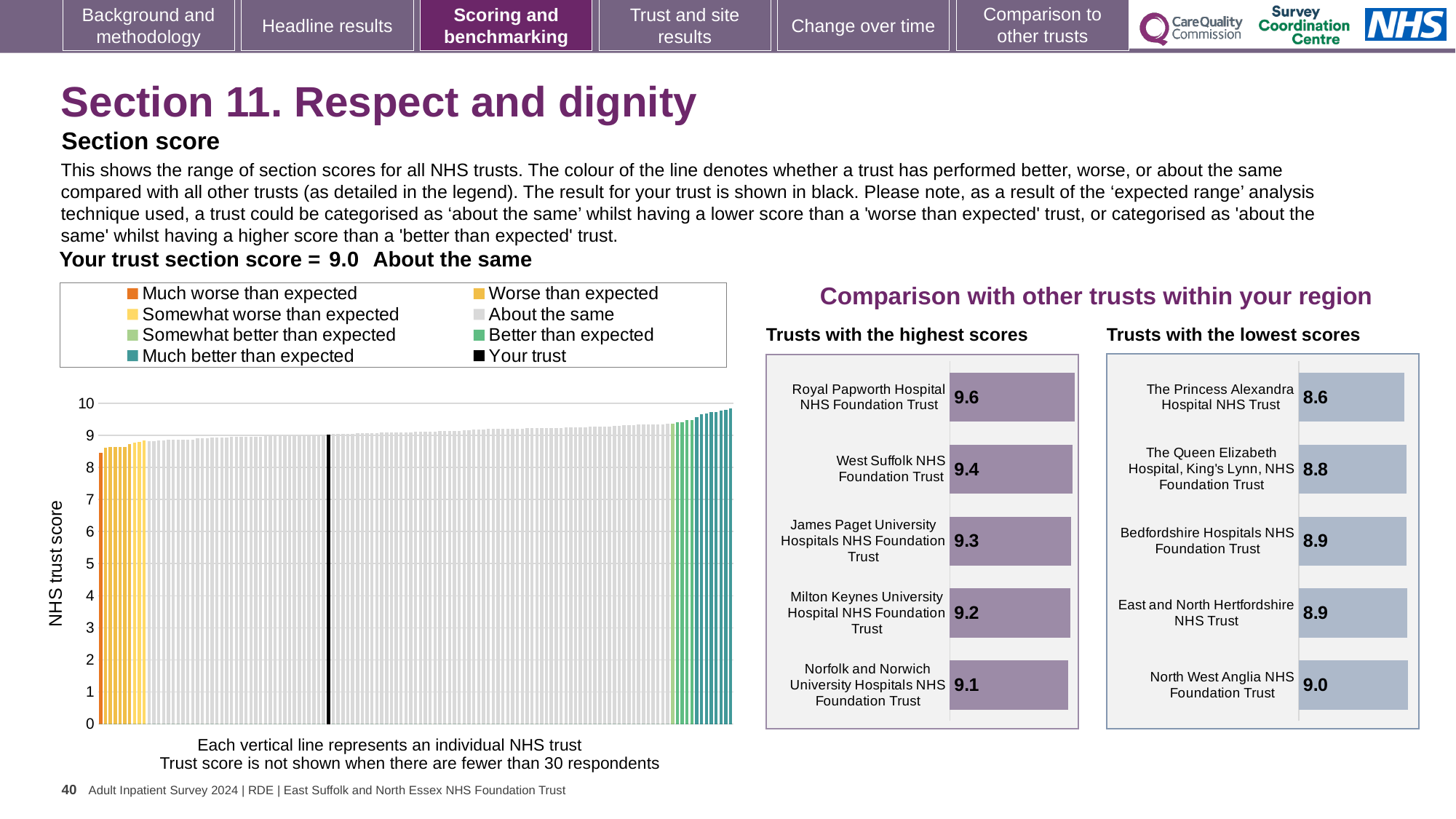
How many entries does the legend of the NHS trust score chart on the left list? 8 How many trusts are shown in the 'Trusts with the highest scores' chart? 5 In the 'Trusts with the highest scores' chart, what is the score for James Paget University Hospitals NHS Foundation Trust? 9.3 In the 'Trusts with the highest scores' chart, what is the score for Royal Papworth Hospital NHS Foundation Trust? 9.6 What is the section score for your trust shown in the NHS trust score chart on the left? 9.0 In the 'Trusts with the lowest scores' chart, which has the larger score: The Queen Elizabeth Hospital, King's Lynn, NHS Foundation Trust or Bedfordshire Hospitals NHS Foundation Trust? Bedfordshire Hospitals NHS Foundation Trust In the 'Trusts with the lowest scores' chart, what is the score for The Princess Alexandra Hospital NHS Trust? 8.6 In the 'Trusts with the highest scores' chart, which trust has the lowest score? Norfolk and Norwich University Hospitals NHS Foundation Trust In the 'Trusts with the highest scores' chart, what is the difference between the scores of Royal Papworth Hospital NHS Foundation Trust and Norfolk and Norwich University Hospitals NHS Foundation Trust? 0.5 In the 'Trusts with the lowest scores' chart, what is the score for North West Anglia NHS Foundation Trust? 9.0 In the 'Trusts with the lowest scores' chart, which trust has the highest score? North West Anglia NHS Foundation Trust What type of chart is the NHS trust score chart on the left of the slide? Bar chart